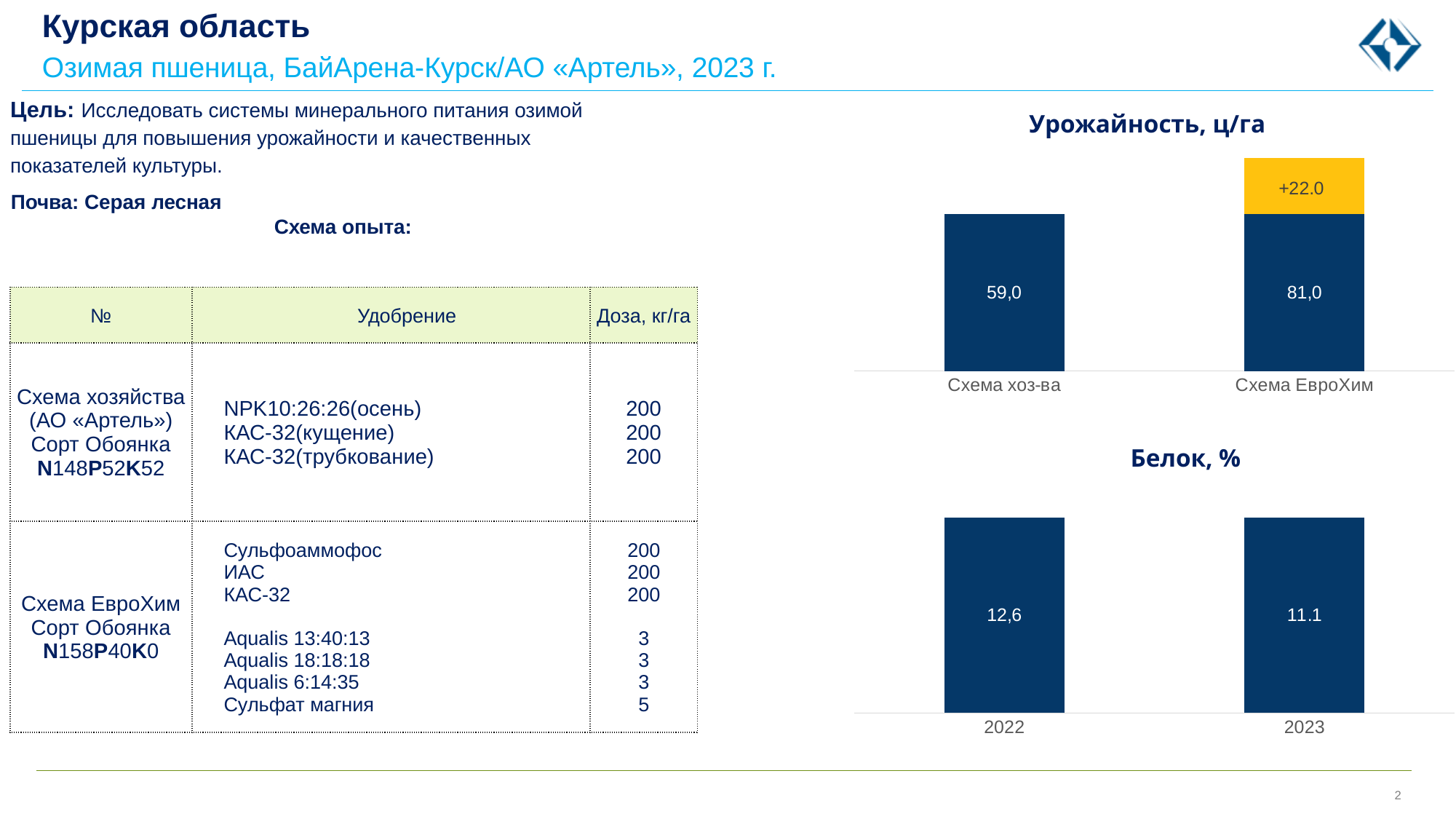
In the chart titled "Урожайность, ц/га", what is the value for "Схема хоз-ва"? 59,0 In the chart titled "Белок, %", what is the value for 2022? 12,6 In the chart titled "Урожайность, ц/га", what is the value for "Схема ЕвроХим"? 81,0 In the chart titled "Белок, %", what is the value for 2023? 11.1 In the chart titled "Белок, %", do the values rise or fall from 2022 to 2023? fall In the chart titled "Белок, %", which year has the lower value? 2023 What kind of chart is the one titled "Урожайность, ц/га"? bar chart In the chart titled "Белок, %", is the value for 2022 larger or smaller than the value for 2023? larger In the chart titled "Урожайность, ц/га", what increase is shown in the orange segment above the "Схема ЕвроХим" bar? +22.0 In the chart titled "Урожайность, ц/га", how many categories are shown on the x axis? 2 In the chart titled "Урожайность, ц/га", what is the difference between "Схема ЕвроХим" and "Схема хоз-ва"? 22,0 In the chart titled "Урожайность, ц/га", which category has the higher value? Схема ЕвроХим